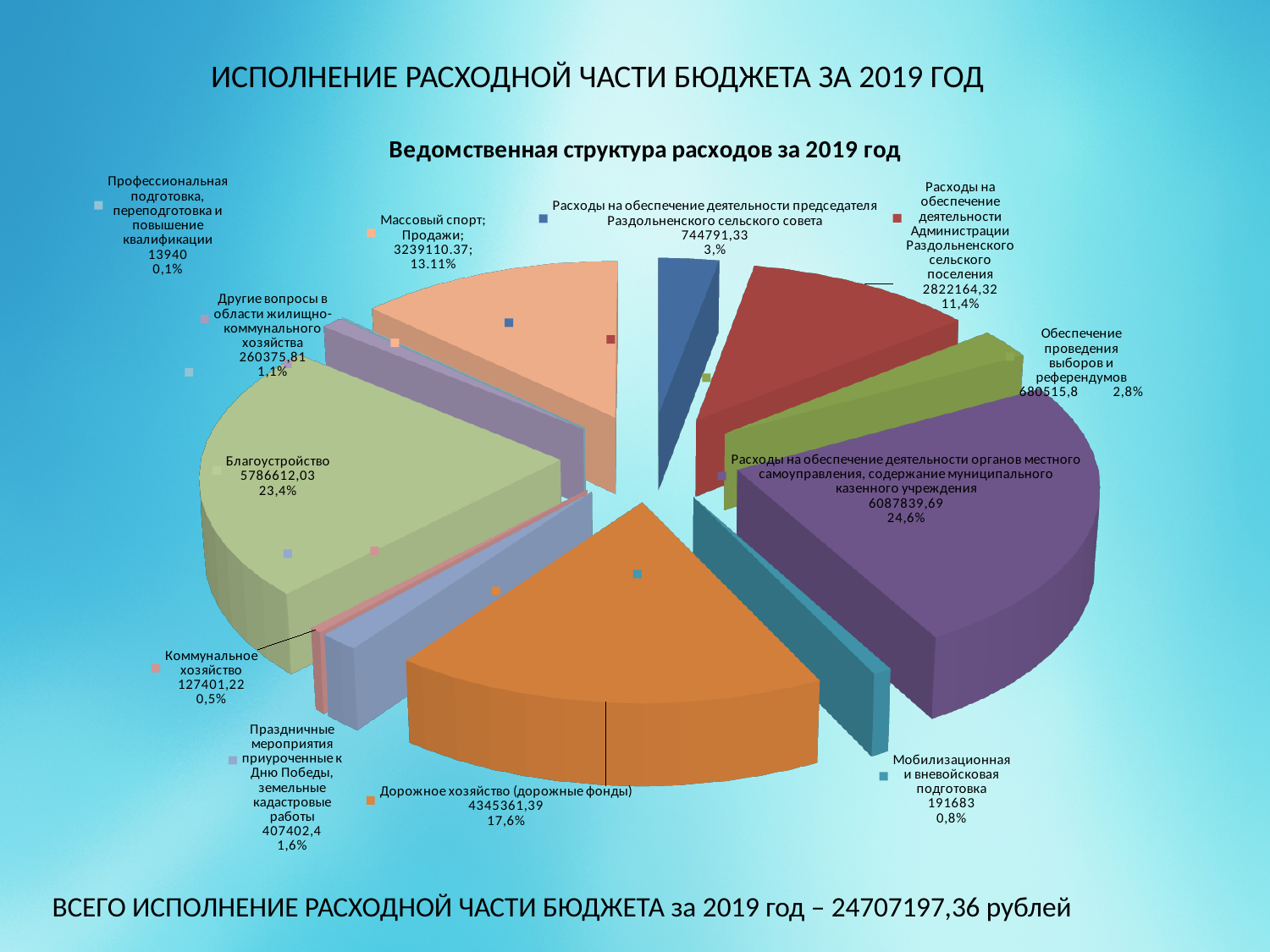
Which category has the smallest value? Профессиональная подготовка, переподготовка и повышение квалификации Which category has the largest value? Расходы на обеспечение деятельности органов местного самоуправления, содержание муниципального казенного учреждения What is the value for Коммунальное хозяйство? 127401,22 What is the difference between the values for Расходы на обеспечение деятельности Администрации Раздольненского сельского поселения and Обеспечение проведения выборов и референдумов? 2141648,52 How many categories (slices) does the pie chart have? 12 What is the value for Благоустройство? 5786612,03 What share of the pie does Мобилизационная и вневойсковая подготовка represent? 0,8% What is the title of the chart? Ведомственная структура расходов за 2019 год What kind of chart is shown on the slide? Pie chart What share of the pie does Расходы на обеспечение деятельности органов местного самоуправления, содержание муниципального казенного учреждения represent? 24,6% Which is larger: Благоустройство or Дорожное хозяйство (дорожные фонды)? Благоустройство What is the value for Дорожное хозяйство (дорожные фонды)? 4345361,39